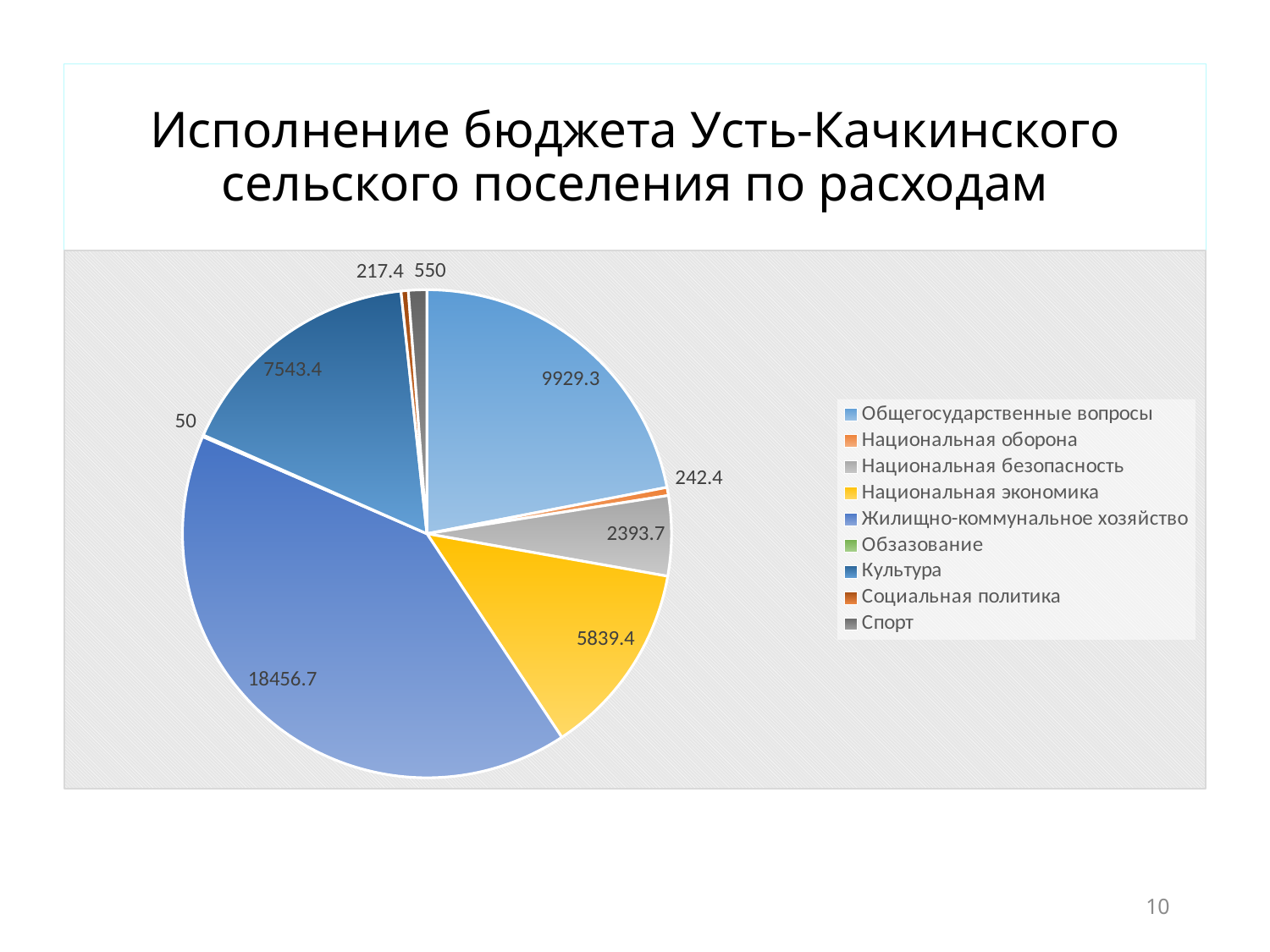
What is the difference between the values for Жилищно-коммунальное хозяйство and Общегосударственные вопросы? 8527.4 Which is larger, Культура or Национальная экономика? Культура Which category has the smallest slice of the pie? Обзазование What is the title of the chart on the slide? Исполнение бюджета Усть-Качкинского сельского поселения по расходам What is the value for Спорт? 550 How many categories does the legend list? 9 Which category has the largest slice of the pie? Жилищно-коммунальное хозяйство What is the value for Жилищно-коммунальное хозяйство? 18456.7 What is the value for Национальная экономика? 5839.4 What is the value for Культура? 7543.4 What kind of chart is shown on the slide? Pie chart What is the value for Общегосударственные вопросы? 9929.3